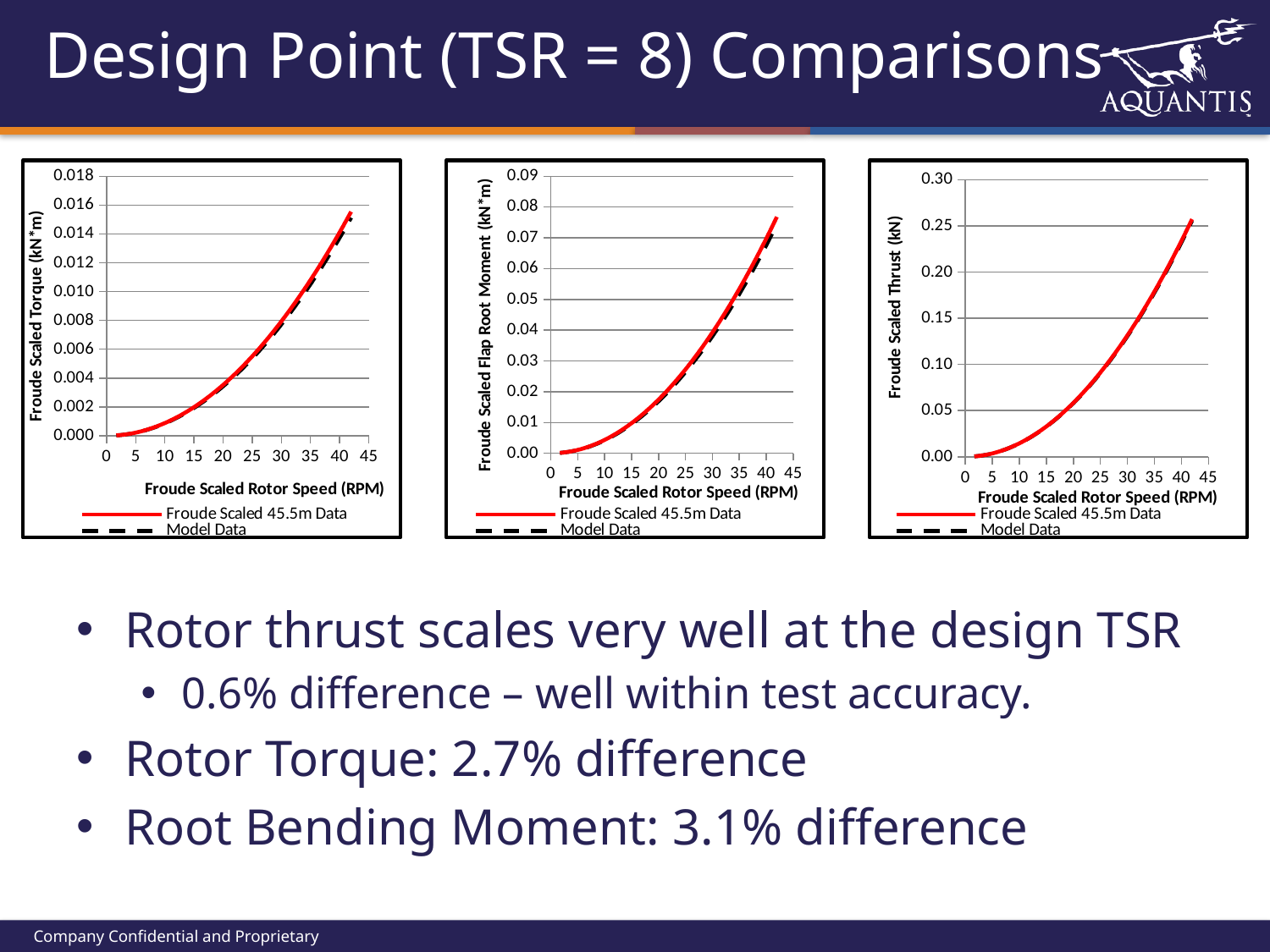
What is the x-axis label of the right chart? Froude Scaled Rotor Speed (RPM) In the left chart (Froude Scaled Torque), is the value at a rotor speed of 40 RPM greater or less than 0.010? greater In the left chart (Froude Scaled Torque), is the value at a rotor speed of 20 RPM greater or less than 0.006? less What kind of chart is the left chart (Froude Scaled Torque vs Rotor Speed)? line chart How many series does the legend of the middle chart (Froude Scaled Flap Root Moment) list? 2 In the middle chart (Froude Scaled Flap Root Moment), do the values rise or fall as rotor speed increases? rise In the right chart (Froude Scaled Thrust), do the values rise or fall as Froude Scaled Rotor Speed increases? rise In the right chart (Froude Scaled Thrust), is the value at a rotor speed of 20 RPM greater or less than 0.10? less Which series is drawn with a dashed line in the left chart? Model Data